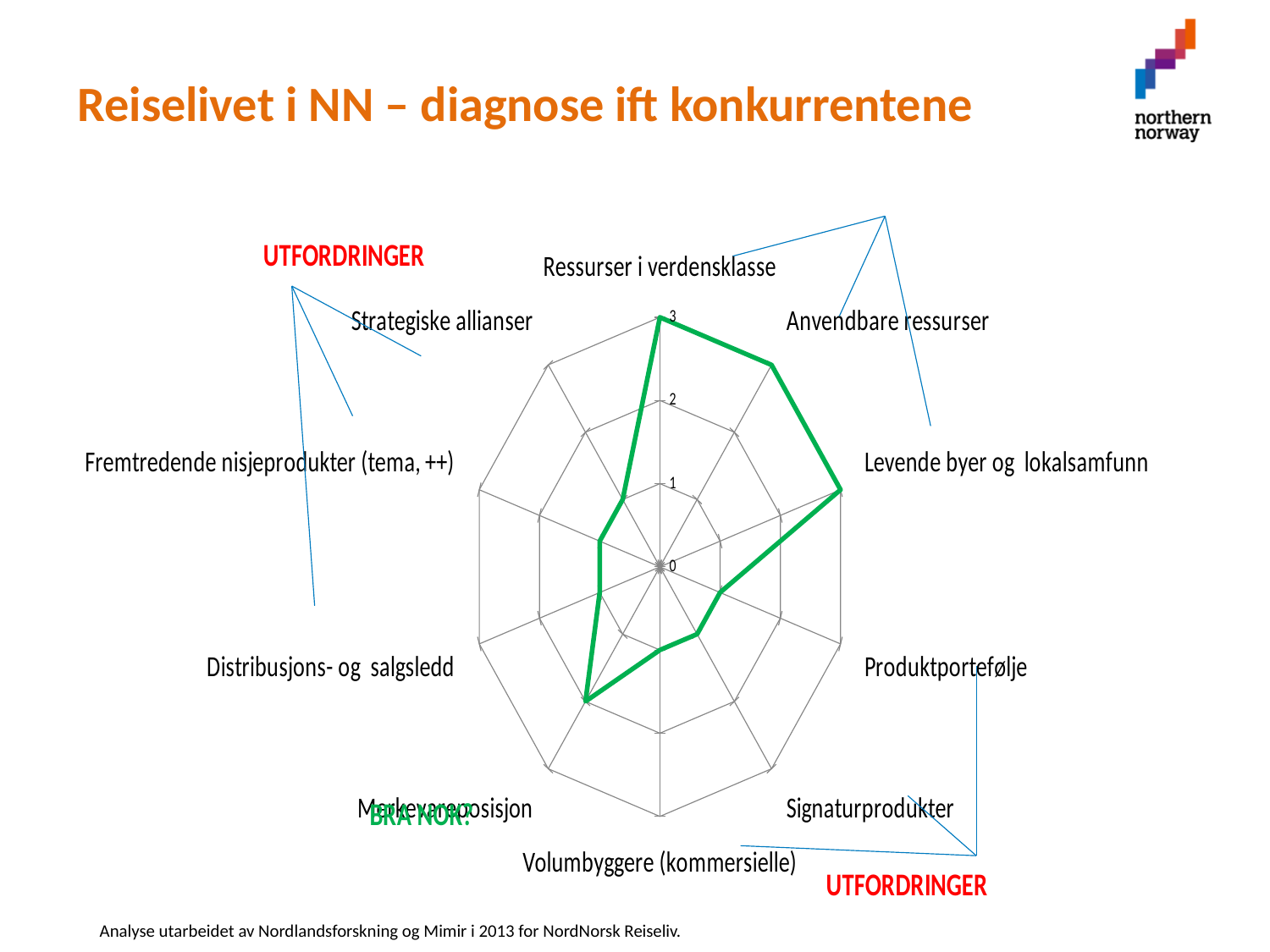
Is the value for Produktportefølje greater or less than 2? less What is the value for Volumbyggere (kommersielle)? 1 What is the value for Ressurser i verdensklasse? 3 How many categories (axes) does the radar chart have? 10 Which is larger, the value for Merkevareposisjon or the value for Distribusjons- og salgsledd? Merkevareposisjon Is the value for Strategiske allianser greater or less than 2? less What is the value for Levende byer og lokalsamfunn? 3 Is the value for Anvendbare ressurser greater or less than 2? greater Which is larger, the value for Ressurser i verdensklasse or the value for Signaturprodukter? Ressurser i verdensklasse What is the highest value shown on the radar chart's scale? 3 What kind of chart is shown on the slide? Radar chart What is the title of the slide containing the chart? Reiselivet i NN – diagnose ift konkurrentene